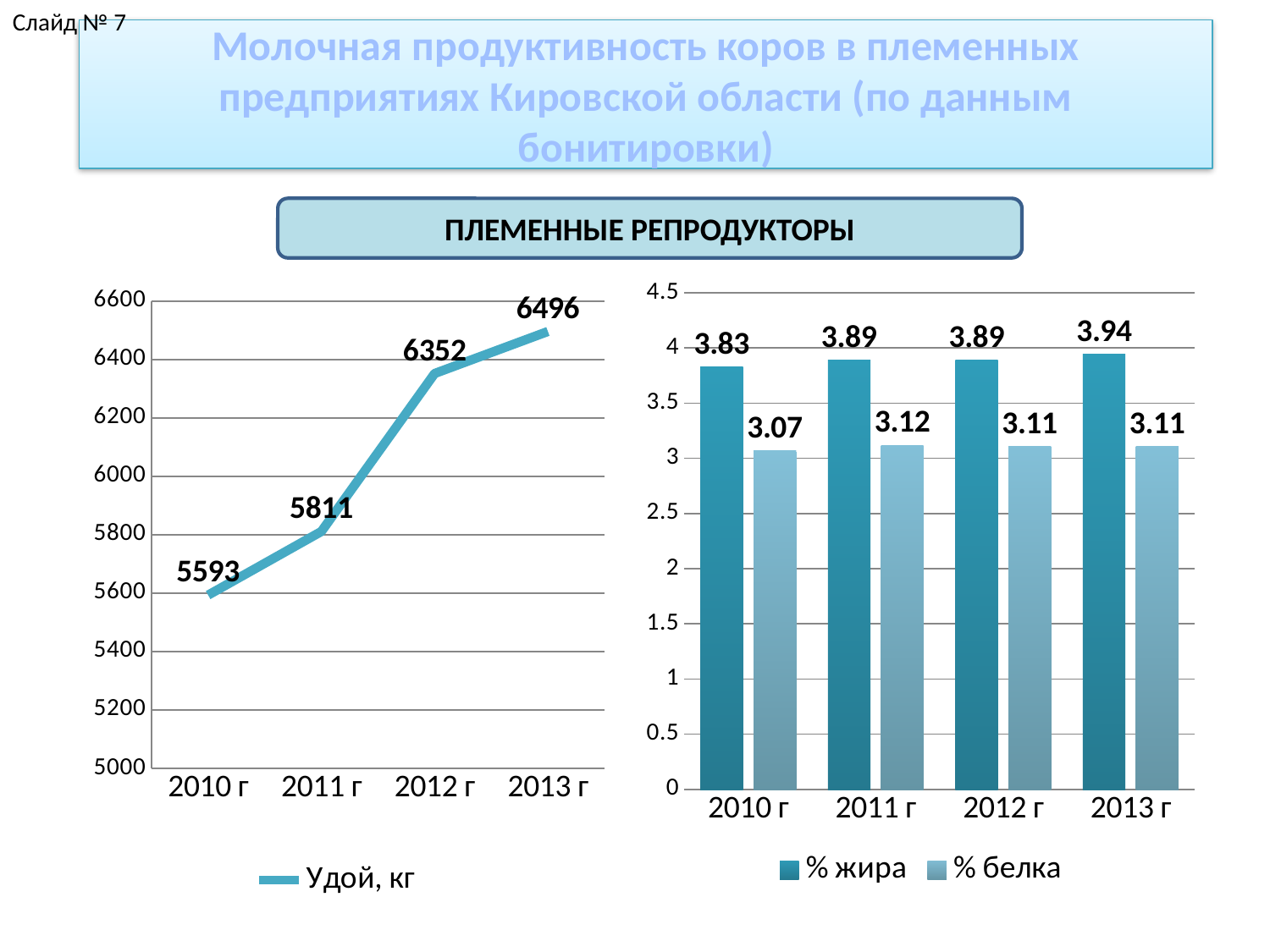
In the left chart (Удой, кг), which year has the lowest value? 2010 г In the left chart (Удой, кг), what is the value for 2010 г? 5593 In the left chart (Удой, кг), do the values rise or fall from 2010 г to 2013 г? rise In the left chart (Удой, кг), what is the value for 2013 г? 6496 In the right chart, what is the % жира value for 2013 г? 3.94 What kind of chart is the left chart (Удой, кг)? line chart In the right chart, what is the % белка value for 2011 г? 3.12 In the left chart (Удой, кг), what is the difference between the values for 2012 г and 2011 г? 541 How many series does the legend of the right chart list? 2 In the right chart, which is larger for 2010 г: % жира or % белка? % жира In the right chart, which year has the highest % жира value? 2013 г What kind of chart is the right chart? bar chart